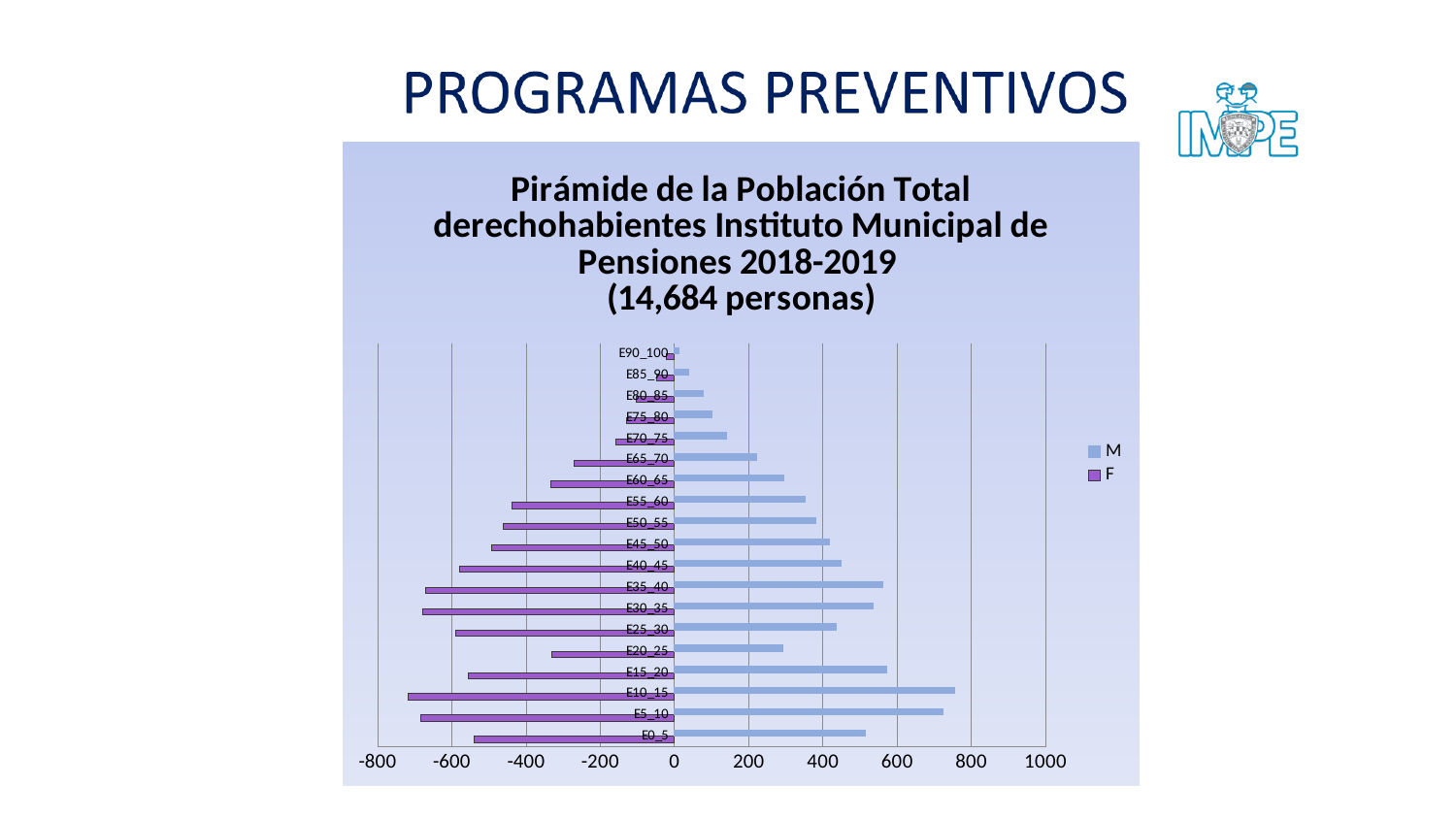
Is the M value for E10_15 greater or less than 600? greater What kind of chart is shown on the slide? Bar chart For the M series, which is larger: the value for E10_15 or the value for E20_25? E10_15 Which age group has the lowest value for the M series? E90_100 How many age-group categories are plotted on the chart? 19 Is the M value for E35_40 greater or less than 400? greater How many series does the legend list? 2 What is the total number of people stated in the chart title? 14,684 personas Which age group has the highest value for the M series? E10_15 Which colour represents the F series in the chart? Purple Is the M value for E85_90 greater or less than 200? less